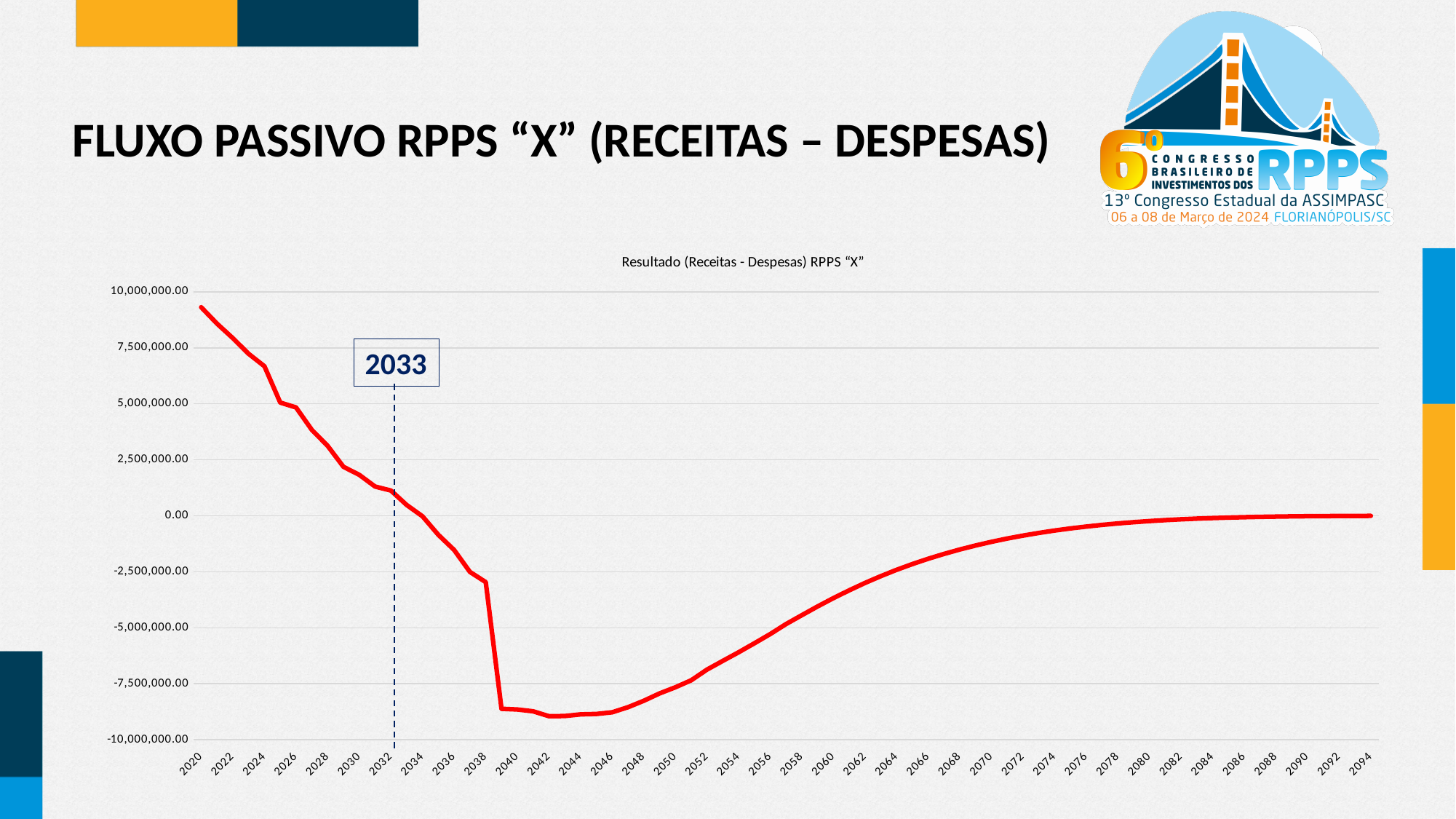
Which year is marked by the dashed vertical line and the boxed label on the chart? 2033 Is the value for 2036 greater or less than 0.00? less Is the value for 2020 greater or less than 7,500,000.00? greater Is the value for 2070 greater or less than 0.00? less What is the title of the chart? Resultado (Receitas - Despesas) RPPS "X" Which year has the highest value on the chart? 2020 What kind of chart is shown on the slide? line chart Which is larger, the value for 2040 or the value for 2060? 2060 Do the values rise or fall from 2020 to 2040? fall